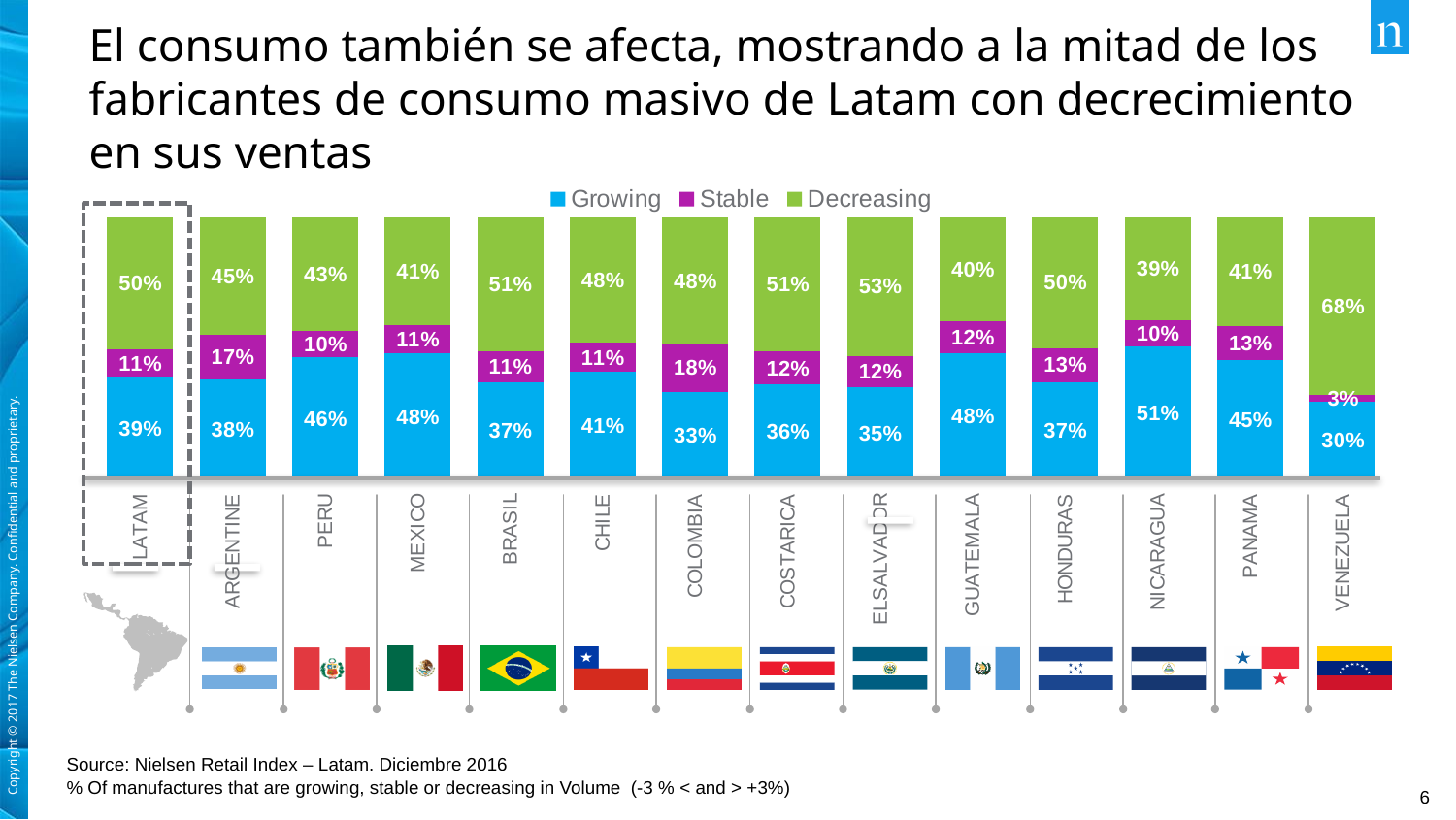
Which country has the highest Growing value? NICARAGUA Which country has the lowest Growing value? VENEZUELA How many countries/regions are shown along the x axis? 14 How many series does the legend list? 3 What is the Decreasing value for VENEZUELA? 68% What is the Stable value for COLOMBIA? 18% What is the difference between the Decreasing value for VENEZUELA and the Decreasing value for LATAM? 18% What is the Growing value for LATAM? 39% Which is larger, the Growing value for MEXICO or the Growing value for BRASIL? MEXICO Which country has the highest Decreasing value? VENEZUELA What is the total of the stacked bar for LATAM? 100% What kind of chart is shown on the slide? Stacked bar chart